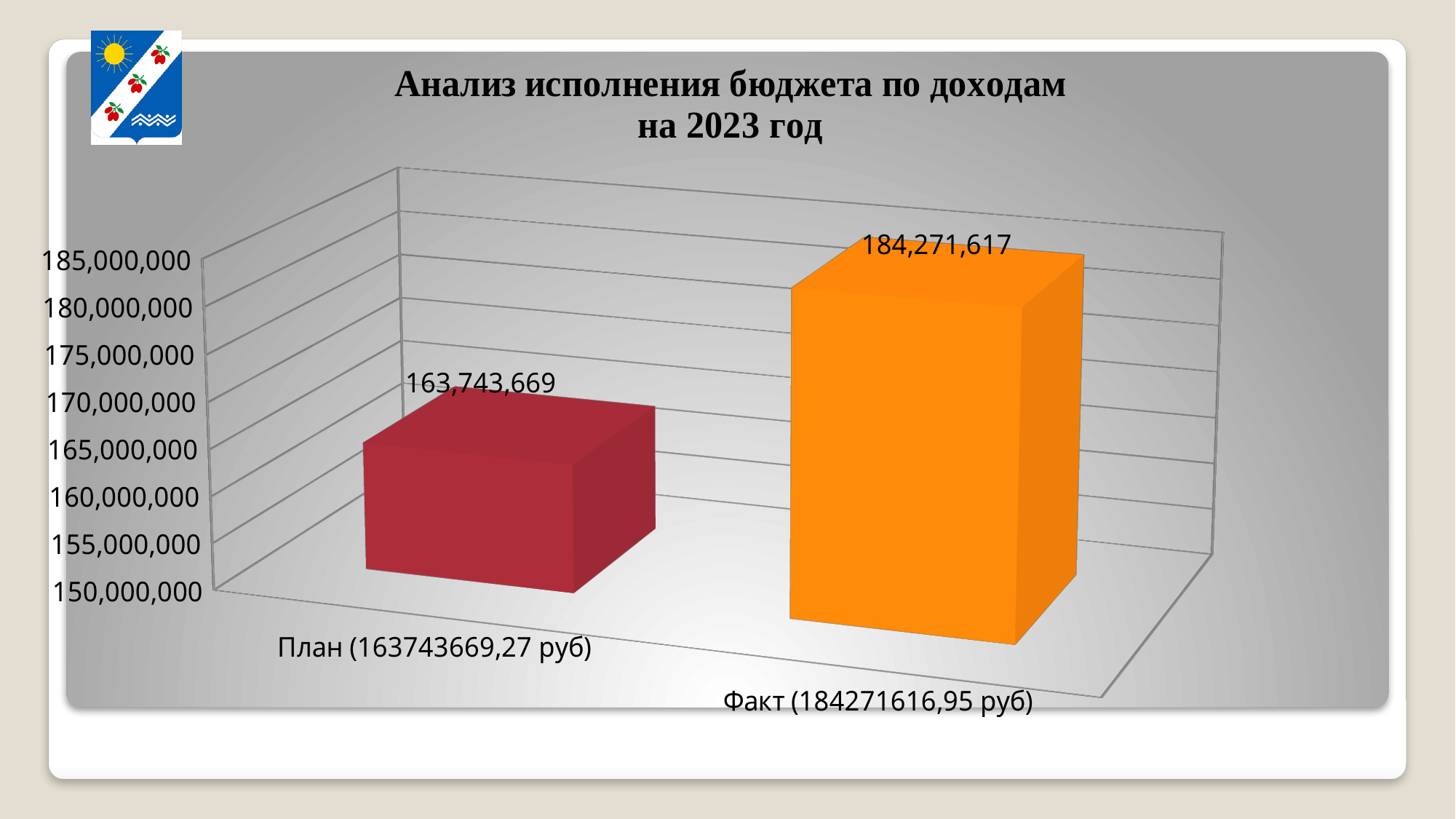
Is the value for План greater or less than the value for Факт? less What type of chart is shown on the slide? Bar chart How many bars are plotted on the chart? 2 What is the title of the chart? Анализ исполнения бюджета по доходам на 2023 год What value is shown for План (plan) on the chart? 163,743,669 Is the value for План greater or less than 165,000,000? less Is the value for Факт greater or less than 180,000,000? greater What value is shown for Факт (actual) on the chart? 184,271,617 Which category has the lowest value on the chart? План What is the difference between the Факт value and the План value? 20,527,948 Which category has the higher value, План or Факт? Факт What colour is the bar for Факт? Orange